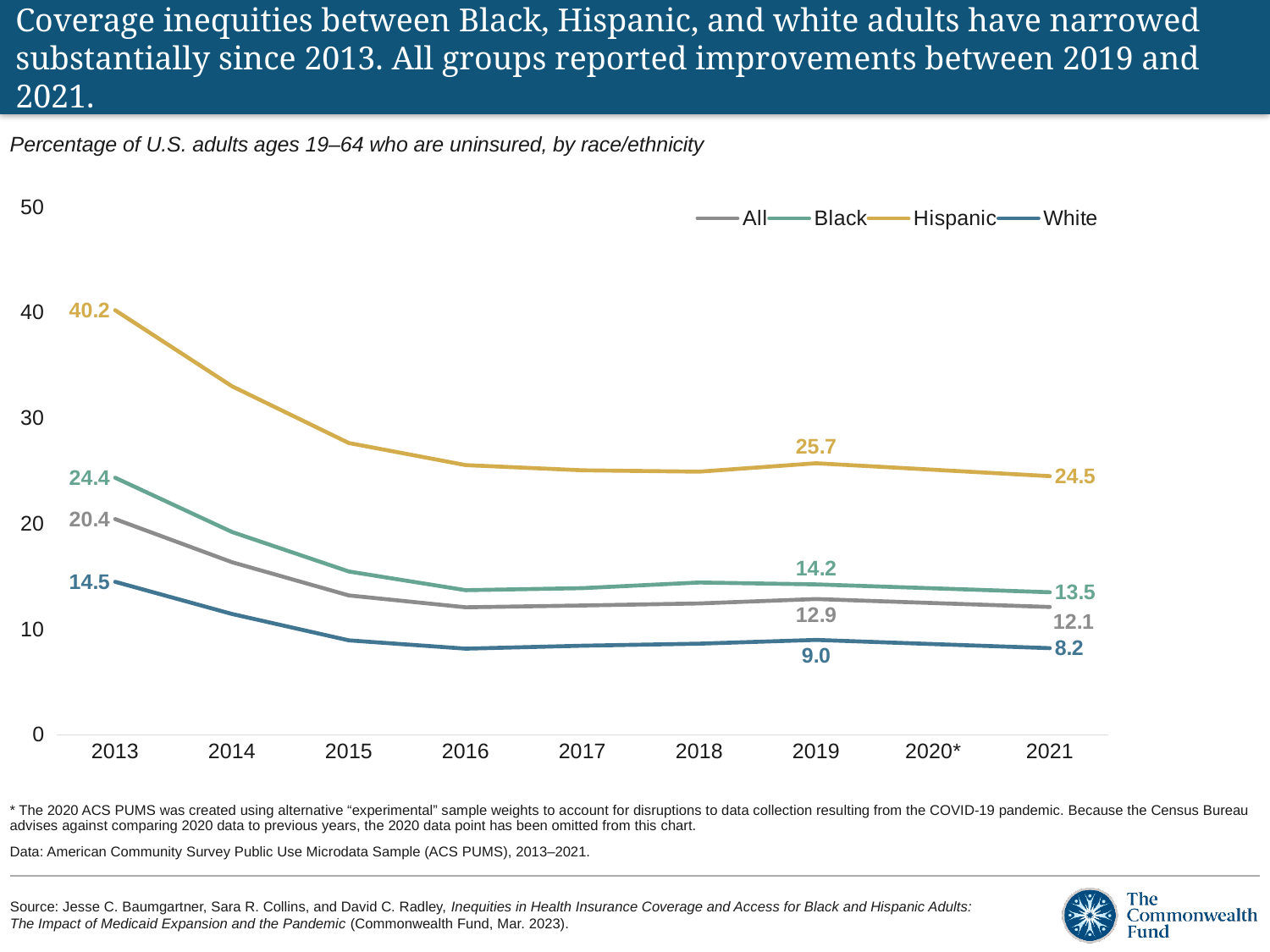
Is the value for Hispanic adults in 2015 greater or less than 30? less What was the uninsured percentage for Hispanic adults in 2013? 40.2 By how many percentage points did the Hispanic uninsured rate fall from 2013 to 2021? 15.7 What type of chart is shown on the slide? Line chart What is the difference between the Black and White uninsured percentages in 2019? 5.2 What was the uninsured percentage for White adults in 2021? 8.2 Does the uninsured percentage for Hispanic adults rise or fall from 2013 to 2016? Fall Which group had the lowest uninsured percentage in 2021? White Which group had the highest uninsured percentage in 2013? Hispanic What was the uninsured percentage for Black adults in 2019? 14.2 How many series does the legend list? 4 What was the uninsured percentage for All adults in 2021? 12.1